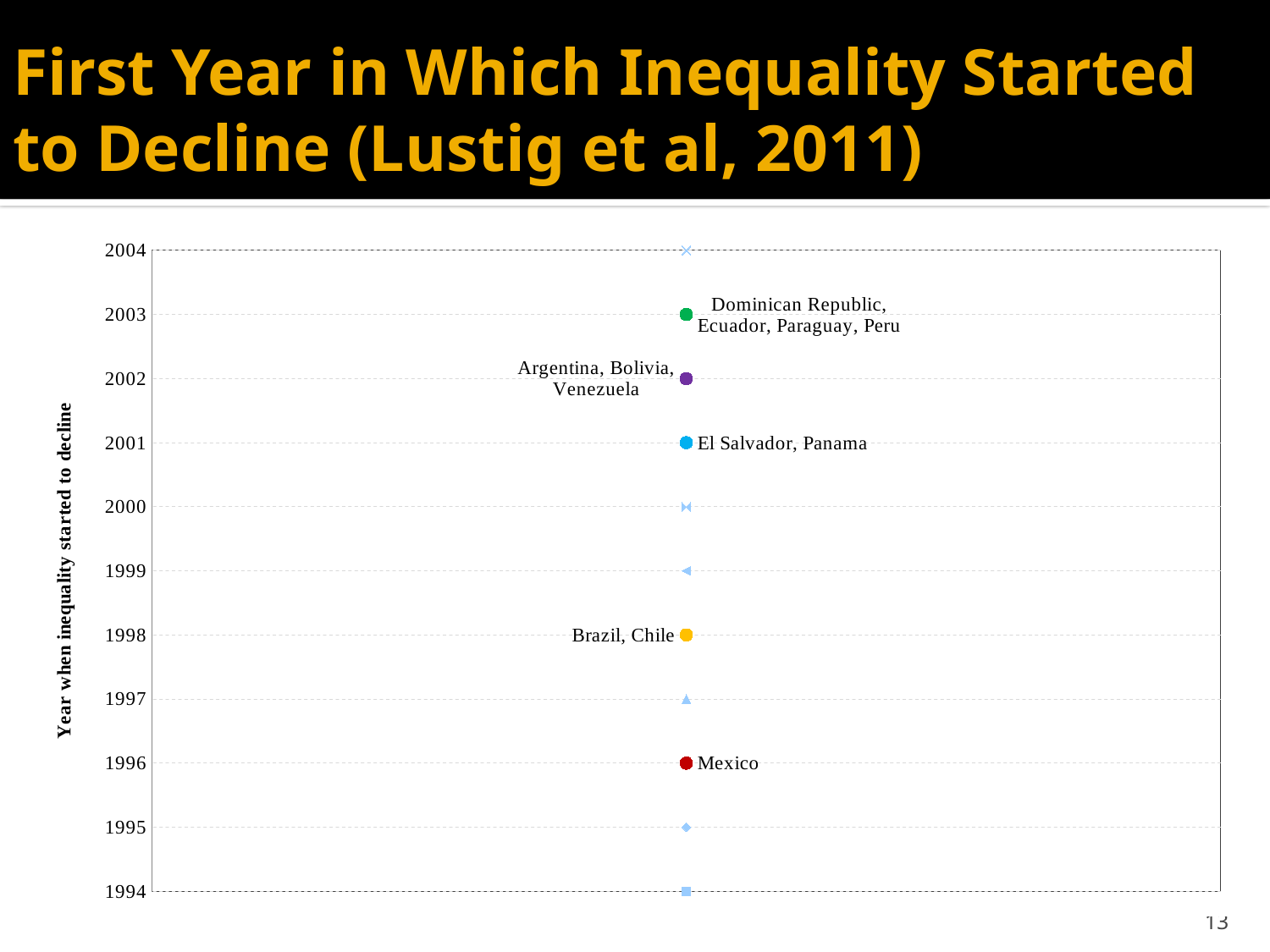
How many years separate the point for the Dominican Republic, Ecuador, Paraguay and Peru from the point for Mexico? 7 In what year did inequality start to decline in Mexico according to the chart? 1996 Among the labelled points, which group has the latest year? Dominican Republic, Ecuador, Paraguay, Peru Among the labelled points, which country has the earliest year? Mexico What year is plotted for El Salvador and Panama? 2001 What is the title of the vertical axis? Year when inequality started to decline Which started to see inequality decline earlier, Mexico or Brazil and Chile? Mexico What year is plotted for the Dominican Republic, Ecuador, Paraguay and Peru? 2003 What year is plotted for Brazil and Chile? 1998 What kind of chart is shown on the slide? Scatter chart How many years later is the point for Argentina, Bolivia and Venezuela than the point for Brazil and Chile? 4 What year is plotted for Argentina, Bolivia and Venezuela? 2002